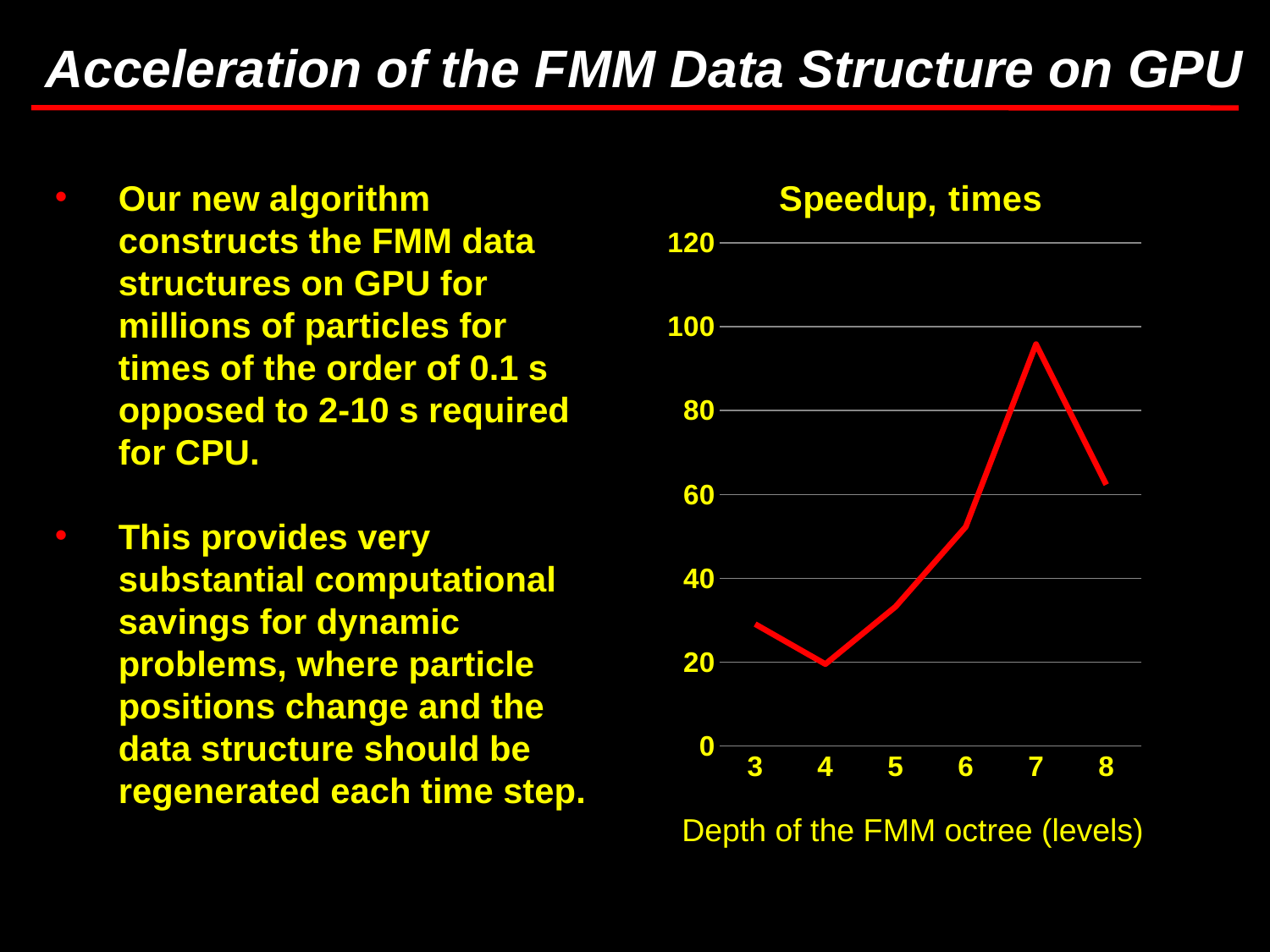
Is the speedup at depth 8 greater or less than 80? less How many data points are plotted on the line? 6 Is the speedup at depth 7 greater or less than 80? greater At which depth of the FMM octree is the speedup highest? 7 Which has the larger speedup, depth 7 or depth 8? 7 What is the title of the chart? Speedup, times Is the speedup at depth 6 greater or less than 40? greater What is the label of the x axis of the chart? Depth of the FMM octree (levels) At which depth of the FMM octree is the speedup lowest? 4 What kind of chart is shown on the slide? line chart Does the speedup rise or fall from depth 4 to depth 7? rise